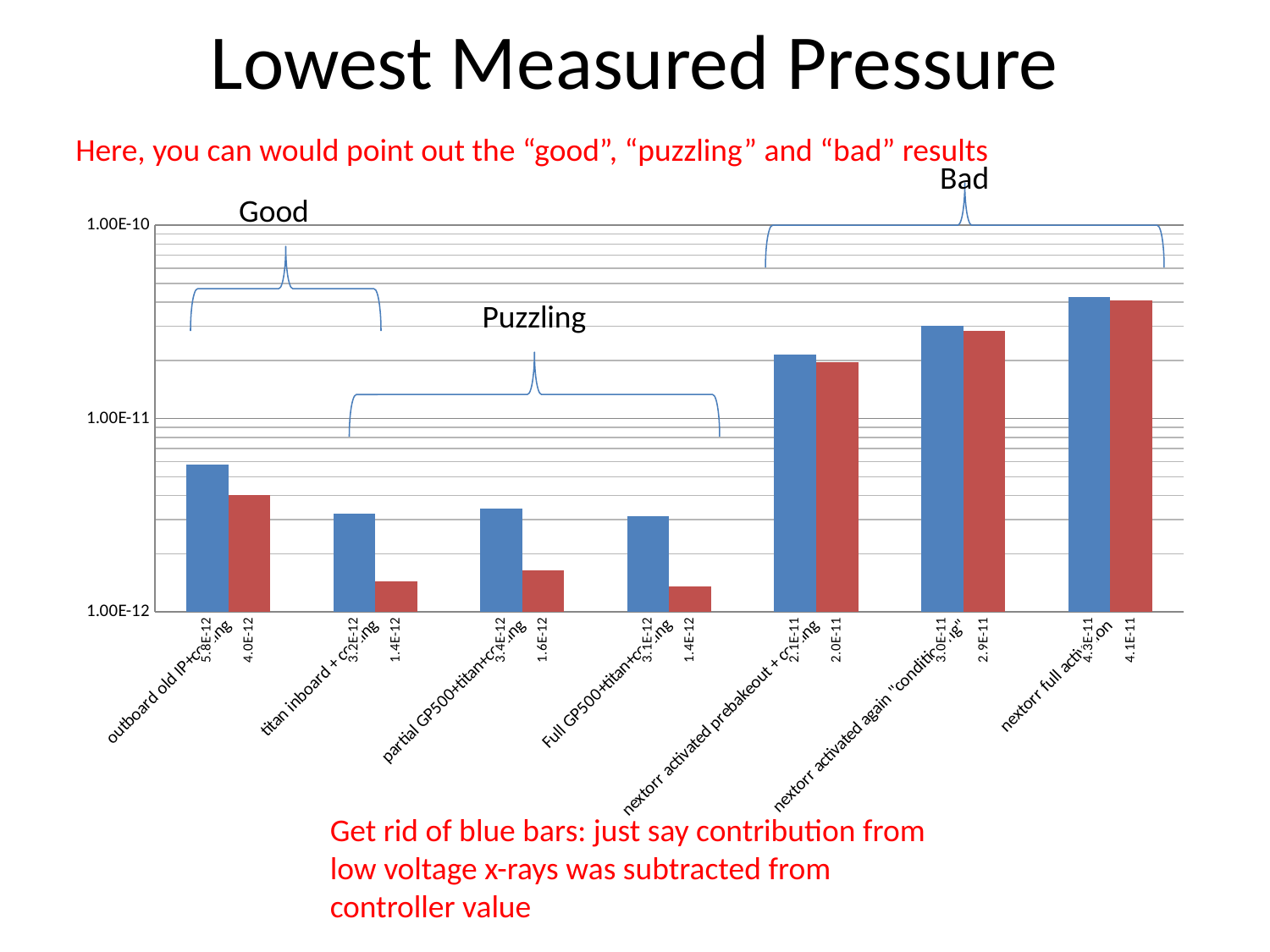
How many categories are plotted along the x axis of the chart? 7 Which category has the highest red bar? nextorr full activation What kind of chart is shown on the slide? bar chart What is the value of the red bar for "nextorr full activation"? 4.1E-11 Do the red bars rise or fall across the three "nextorr" categories from left to right? rise What is the value of the red bar for "outboard old IP"? 4.0E-12 Is the blue bar for "partial GP500+titan" greater or less than 1.00E-11? less Is the red bar for "nextorr activated prebakeout" greater or less than 1.00E-11? greater What is the title of the slide containing the chart? Lowest Measured Pressure What is the value of the blue bar for "nextorr activated prebakeout"? 2.1E-11 Which is larger, the blue bar for "outboard old IP" or the blue bar for "titan inboard"? outboard old IP Which category has the highest blue bar? nextorr full activation